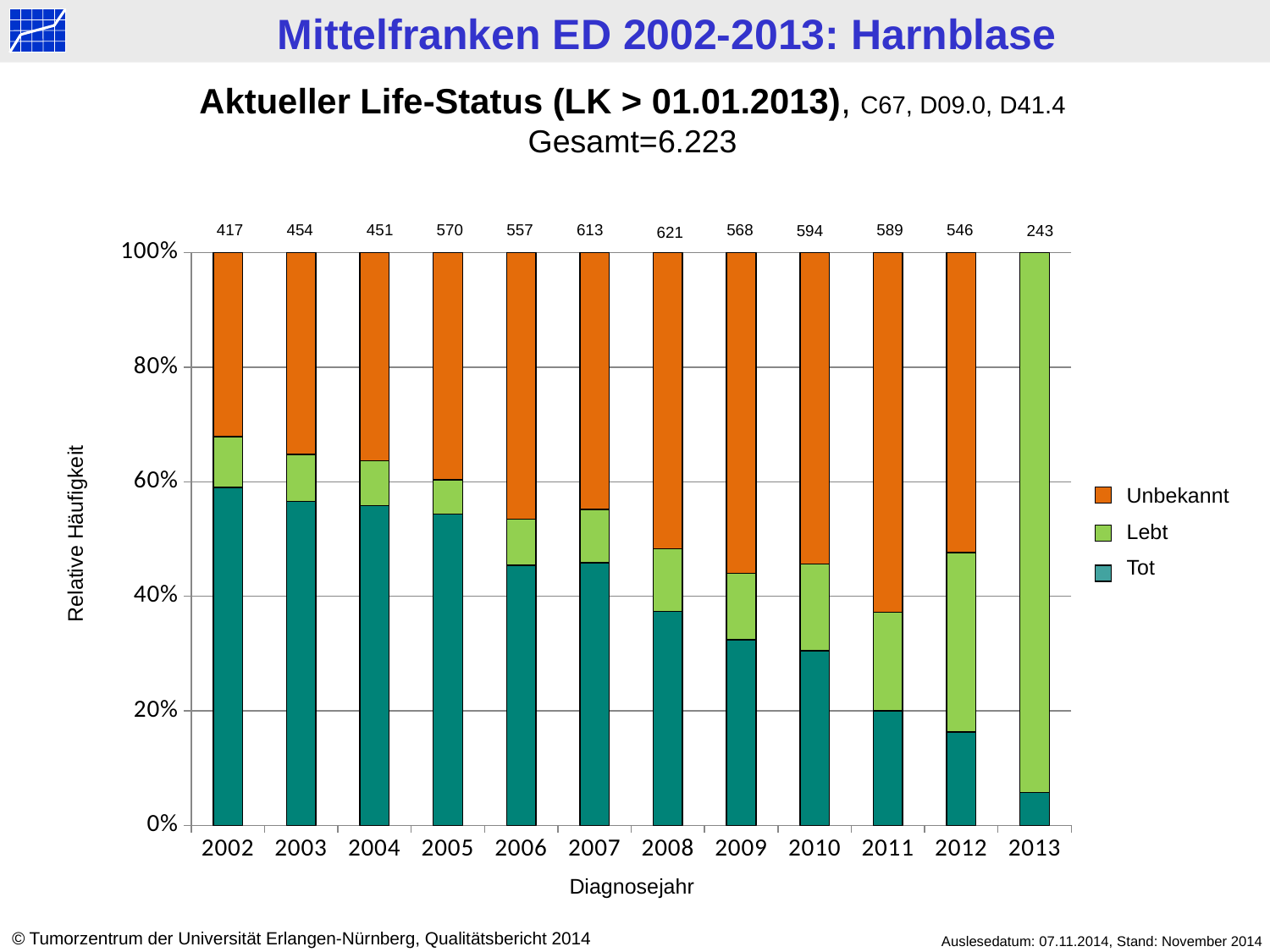
What number is printed above the bar for 2013? 243 Which year has the highest number printed above its bar? 2008 Is the share of Tot in 2002 greater or less than 40%? greater Is the share of Tot in 2012 greater or less than 20%? less How many diagnosis years are shown on the x axis? 12 How many series does the legend list? 3 Does the share of Tot rise or fall from 2002 to 2013? fall What is the difference between the numbers printed above the bars for 2008 and 2013? 378 What kind of chart is shown on the slide? Stacked bar chart Which year has the larger number printed above its bar, 2005 or 2006? 2005 Which year has the lowest number printed above its bar? 2013 What number is printed above the bar for 2008? 621